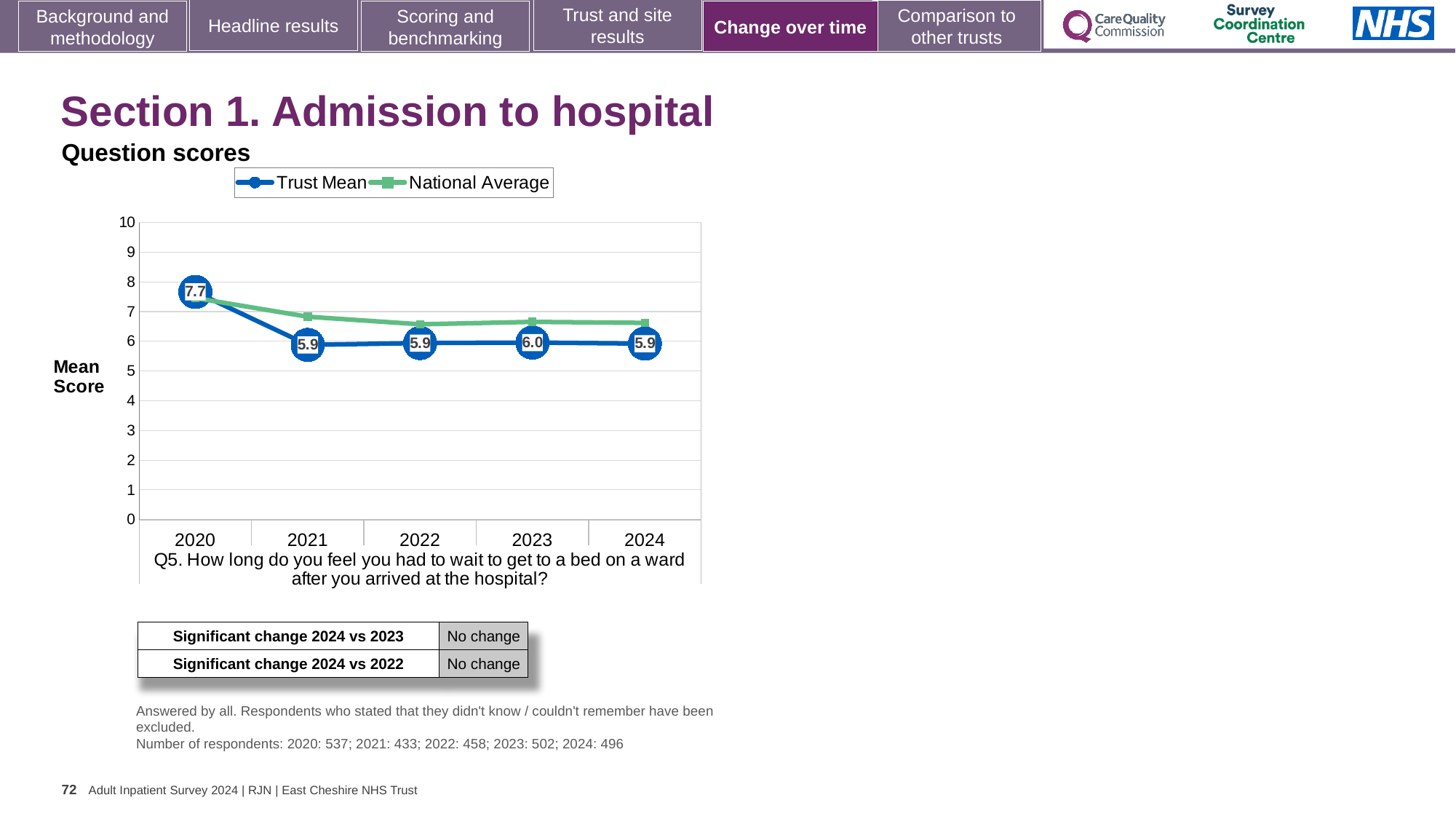
What kind of chart is shown on the slide? Line chart How many series does the legend list? 2 Does the Trust Mean score rise or fall from 2020 to 2021? Fall In which year is the Trust Mean score highest? 2020 What is the Trust Mean score for 2020? 7.7 Is the Trust Mean score higher in 2020 or in 2024? 2020 What is the Trust Mean score for 2024? 5.9 How many years are shown on the x axis? 5 What is the Trust Mean score for 2023? 6.0 Is the National Average value for 2020 greater or less than 8? less What is the difference between the Trust Mean score in 2020 and in 2021? 1.8 Is the National Average value for 2021 greater or less than 6? greater